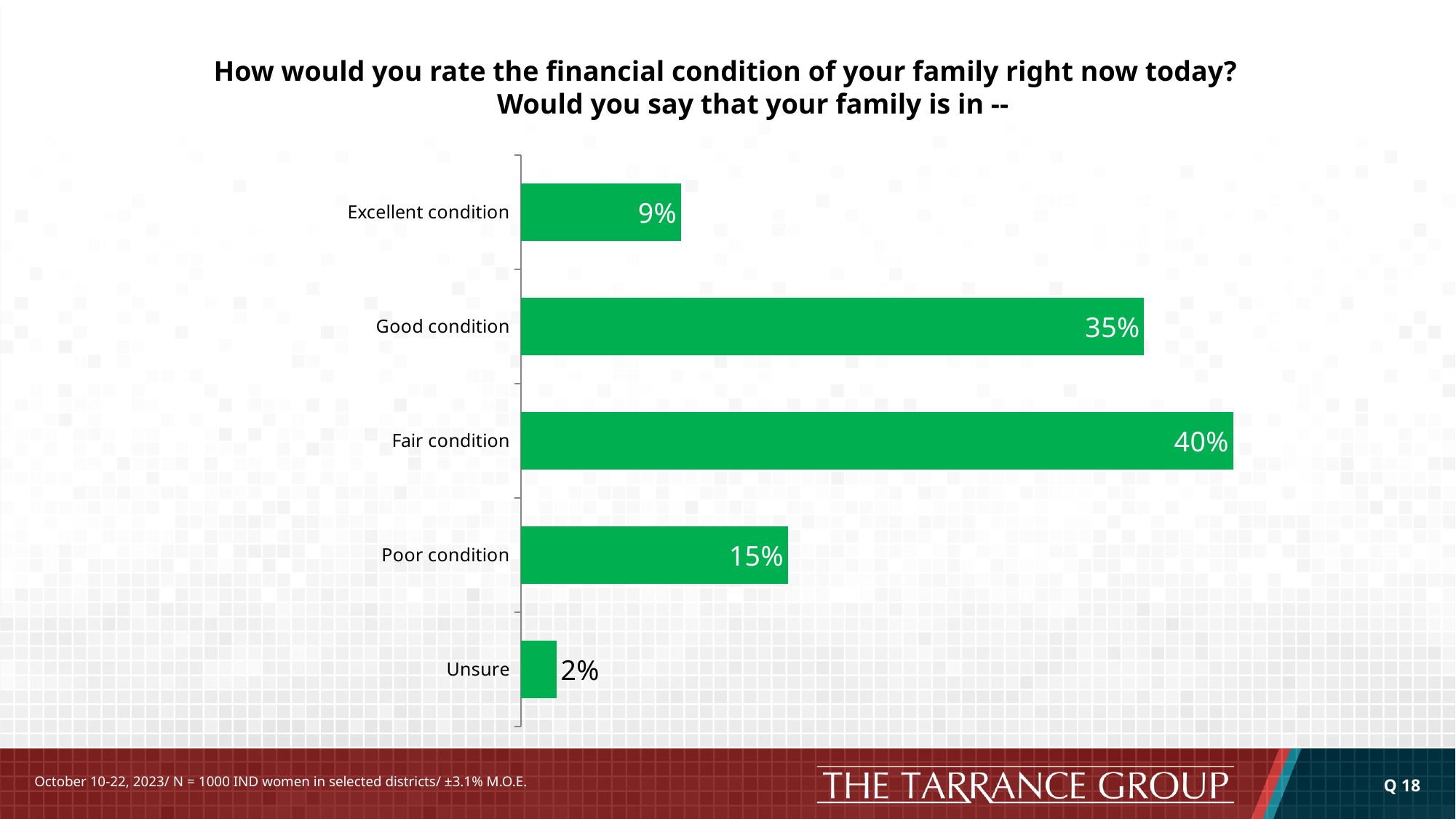
Which response category has the lowest percentage? Unsure Which response category has the highest percentage? Fair condition What percentage of respondents were Unsure? 2% What percentage of respondents said their family is in Poor condition? 15% What is the difference in percentage points between Fair condition and Good condition? 5 What type of chart is shown on the slide? Bar chart What percentage of respondents rated their family's financial condition as Excellent condition? 9% Which is larger, the percentage for Good condition or the percentage for Poor condition? Good condition What percentage of respondents said their family is in Good condition? 35% What is the difference in percentage points between Poor condition and Excellent condition? 6 How many response categories are shown in the chart? 5 What colour are the bars in the chart? Green